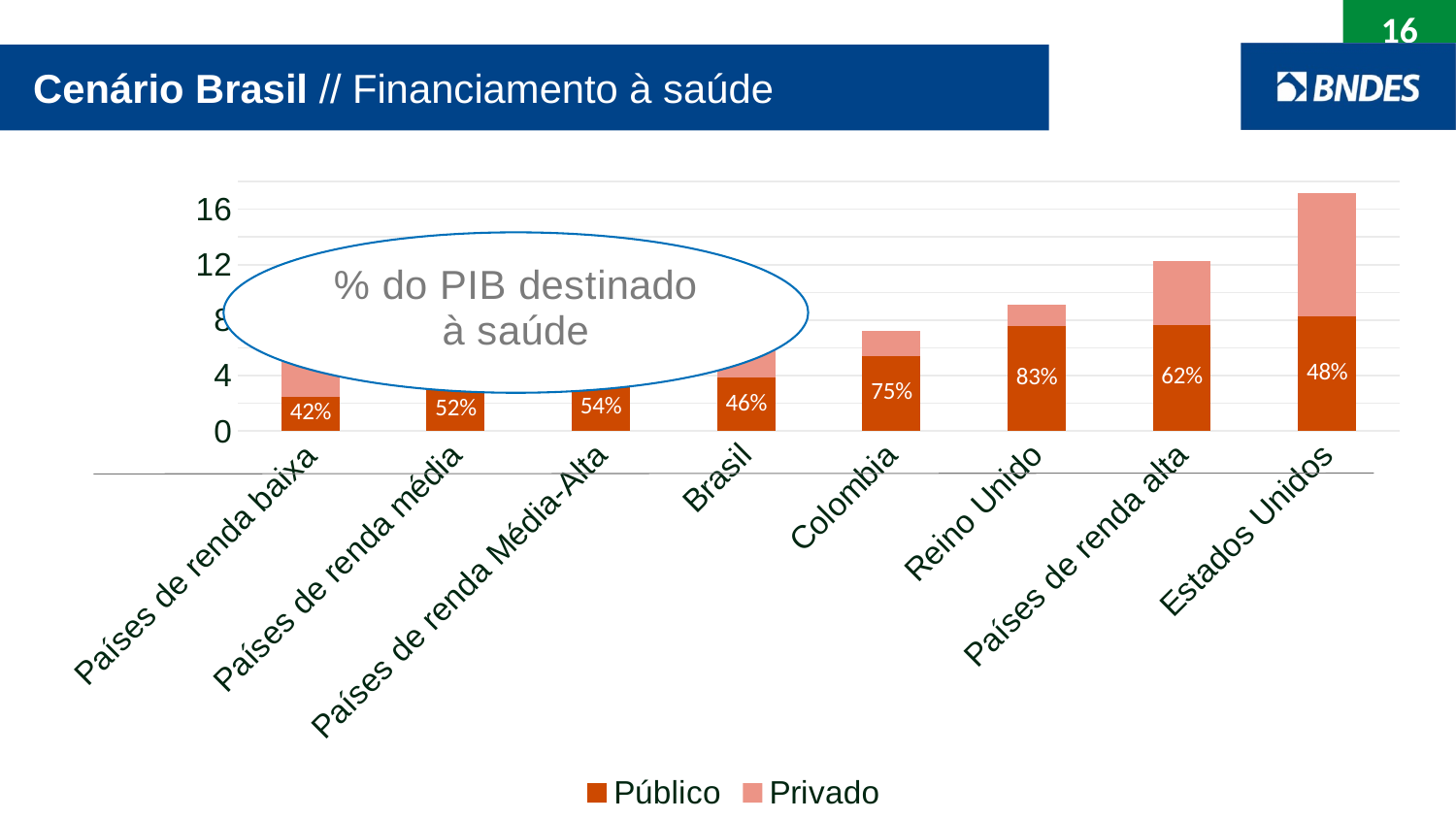
What kind of chart is shown on the slide? Stacked bar chart What percentage label is shown on the Público segment for Brasil? 46% How many series does the legend list? 2 Is the total stacked bar for Colombia greater or less than 8? less Which category has the tallest stacked bar overall? Estados Unidos What percentage label is shown on the Público segment for Estados Unidos? 48% What percentage label is shown on the Público segment for Reino Unido? 83% Which category has the lowest Público percentage label? Países de renda baixa How many categories are shown on the x axis? 8 What percentage label is shown on the Público segment for Países de renda baixa? 42% Which category has the highest Público percentage label? Reino Unido Is the total stacked bar for Estados Unidos greater or less than 16? greater